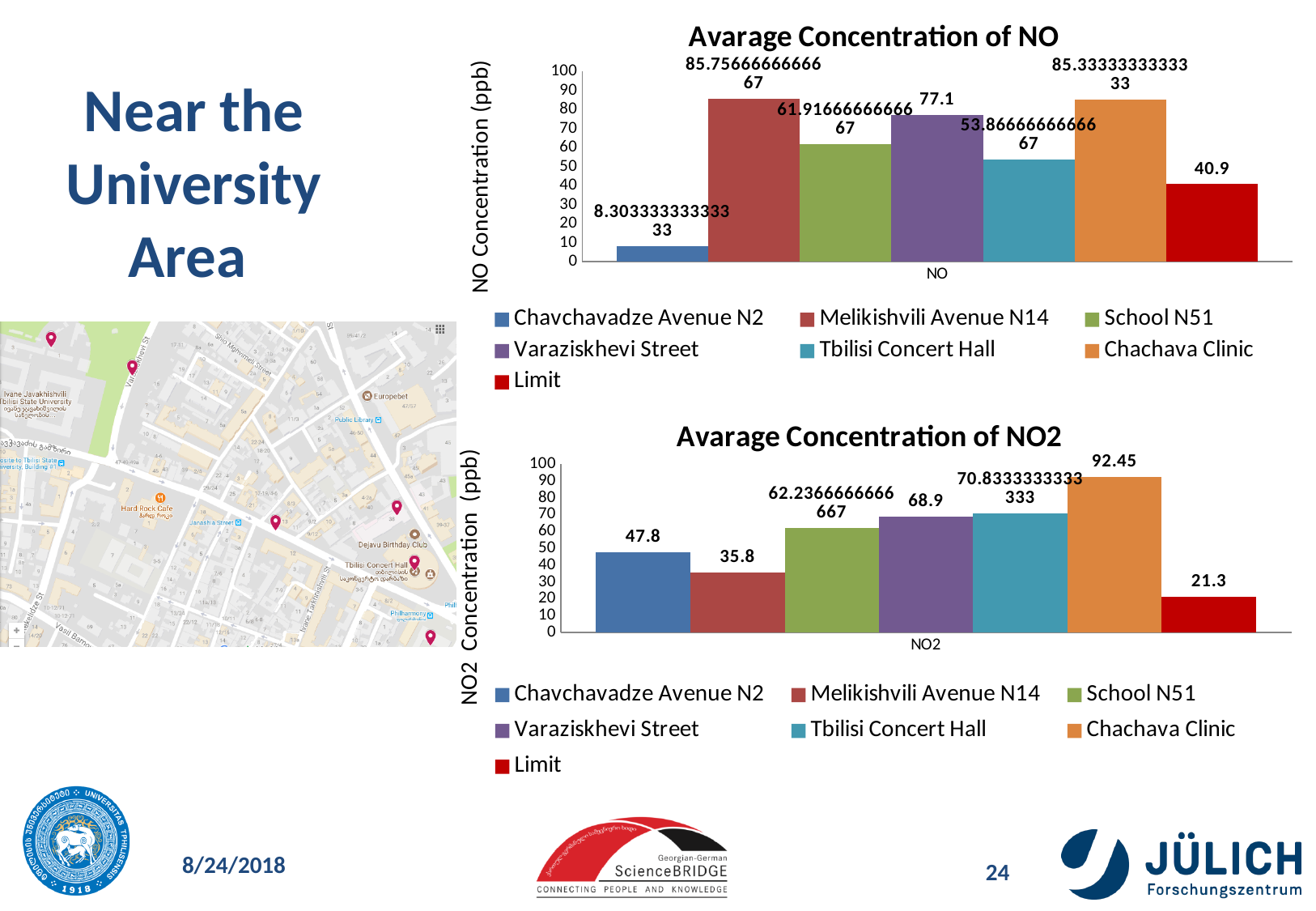
In the Avarage Concentration of NO2 chart, which bar is the highest? Chachava Clinic In the Avarage Concentration of NO chart, what is the difference between the Varaziskhevi Street value and the Limit value? 36.2 In the Avarage Concentration of NO chart, which location has the lowest NO concentration? Chavchavadze Avenue N2 How many series does the legend of the Avarage Concentration of NO2 chart list? 7 In the Avarage Concentration of NO chart, which is larger: Varaziskhevi Street or Tbilisi Concert Hall? Varaziskhevi Street In the Avarage Concentration of NO chart, is the value for Chachava Clinic greater or less than 80? greater In the Avarage Concentration of NO2 chart, what is the difference between Chavchavadze Avenue N2 and Melikishvili Avenue N14? 12 In the Avarage Concentration of NO chart, what is the value of the Limit bar? 40.9 In the Avarage Concentration of NO2 chart, what is the value for Chachava Clinic? 92.45 In the Avarage Concentration of NO2 chart, what is the value for Melikishvili Avenue N14? 35.8 In the Avarage Concentration of NO chart, what is the value for Varaziskhevi Street? 77.1 What type of chart is the Avarage Concentration of NO chart? Bar chart